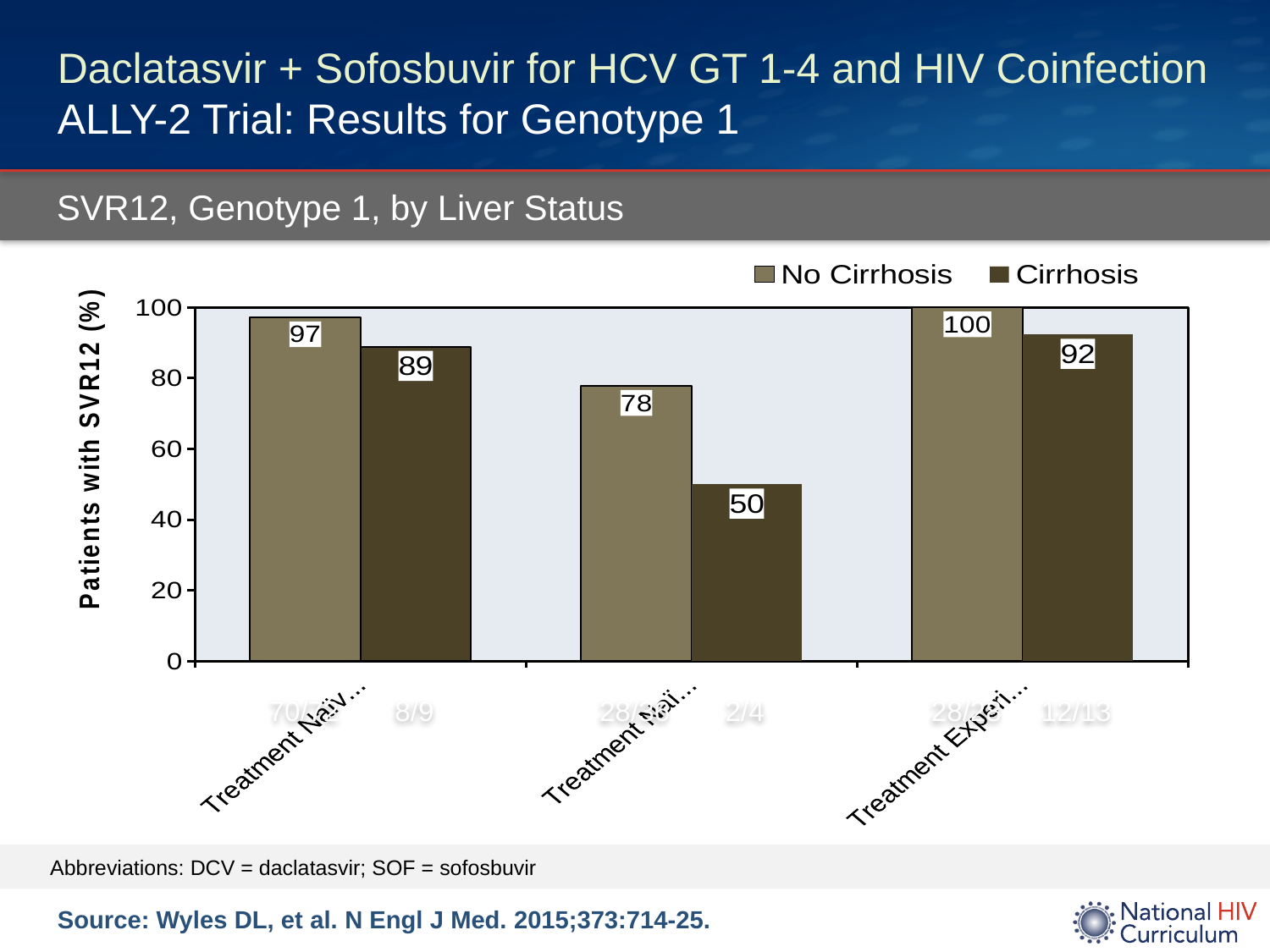
Which bar has the lowest value on the chart? Cirrhosis in the middle group (50) What is the difference between the No Cirrhosis and Cirrhosis values in the middle group of bars? 28 Which bar has the highest value on the chart? No Cirrhosis in the rightmost group (100) What is the Cirrhosis value for the middle group of bars? 50 What is the title of the y-axis? Patients with SVR12 (%) What is the difference between the No Cirrhosis and Cirrhosis values in the leftmost group of bars? 8 Which is larger: the Cirrhosis value in the leftmost group or the Cirrhosis value in the rightmost group? The rightmost group (92) What kind of chart is shown on the slide? Bar chart What is the No Cirrhosis value for the leftmost group of bars? 97 What is the Cirrhosis value for the rightmost group of bars? 92 How many groups of bars are shown on the chart? 3 How many series does the legend list? 2